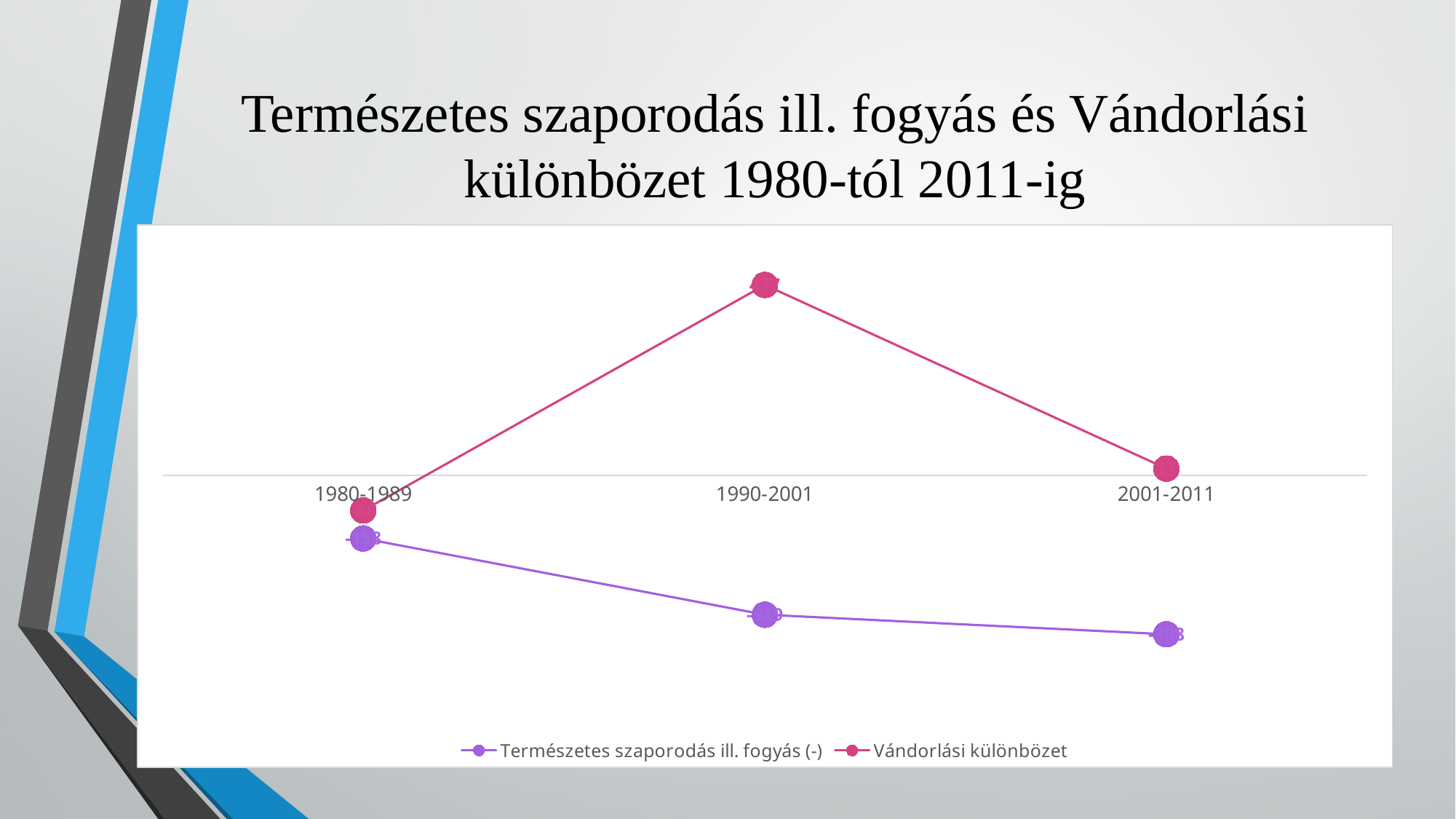
In which period is the Természetes szaporodás ill. fogyás (-) series at its highest? 1980-1989 How many series does the legend list? 2 What colour is the line for the Vándorlási különbözet series? red (pink) Does the Természetes szaporodás ill. fogyás (-) series rise or fall from 1980-1989 to 2001-2011? fall Which series has the higher value in 2001-2011, Természetes szaporodás ill. fogyás (-) or Vándorlási különbözet? Vándorlási különbözet Which series has the higher value in 1990-2001, Természetes szaporodás ill. fogyás (-) or Vándorlási különbözet? Vándorlási különbözet What kind of chart is shown on the slide? line chart In which period is the Vándorlási különbözet series at its lowest? 1980-1989 In which period is the Természetes szaporodás ill. fogyás (-) series at its lowest? 2001-2011 What is the first series listed in the legend? Természetes szaporodás ill. fogyás (-) How many periods are shown on the x axis? 3 In which period is the Vándorlási különbözet series at its highest? 1990-2001